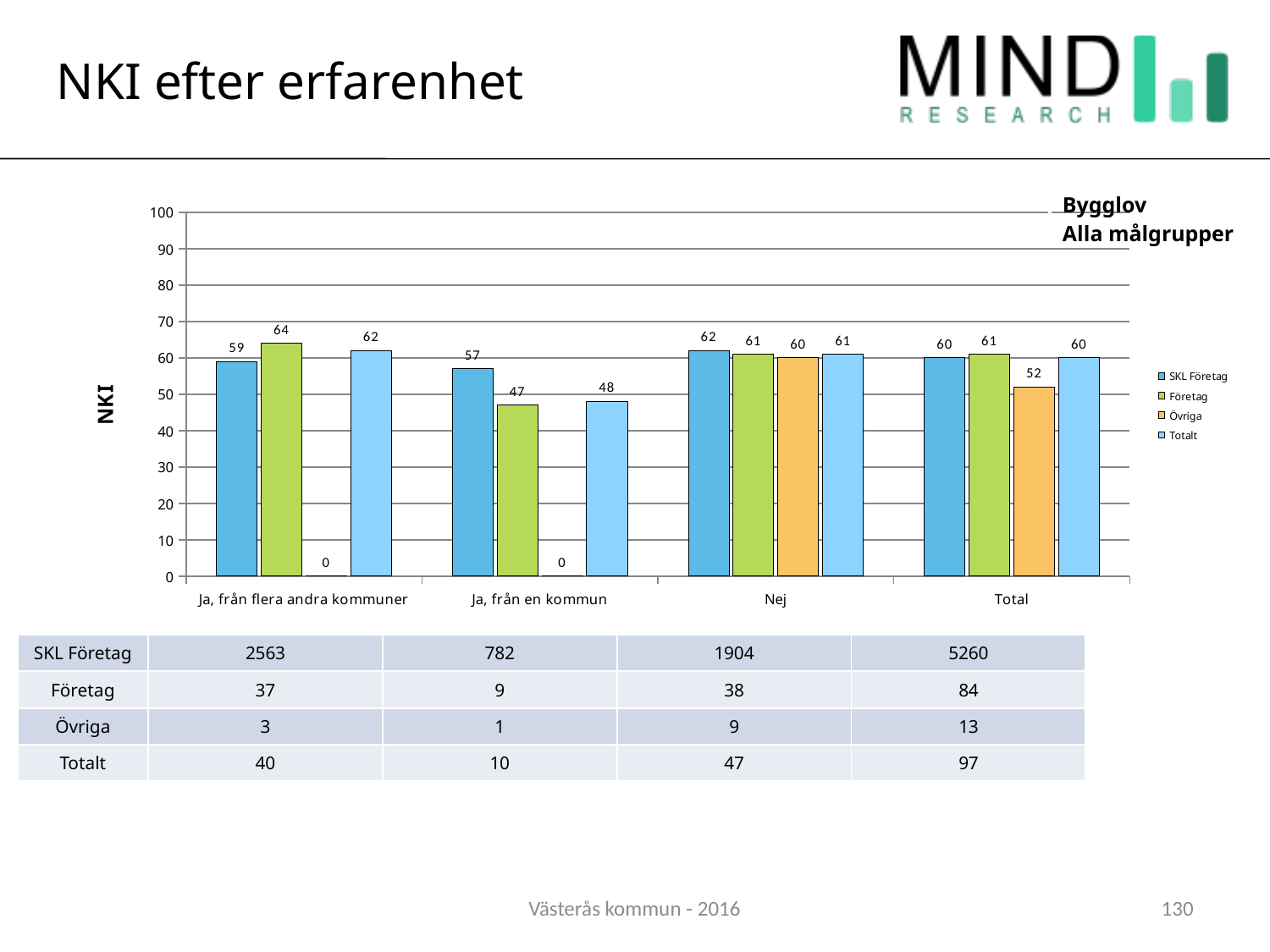
What is the NKI value for Övriga in the 'Total' category? 52 How many series does the legend list? 4 What is the label on the y axis of the chart? NKI What is the NKI value for Totalt in the 'Nej' category? 61 How many categories are shown on the x axis? 4 What is the NKI value for SKL Företag in the 'Ja, från en kommun' category? 57 Which series has the highest value in the 'Ja, från flera andra kommuner' category? Företag Which is larger: the Totalt value for 'Ja, från flera andra kommuner' or the Totalt value for 'Ja, från en kommun'? Ja, från flera andra kommuner What is the difference between the Företag values for 'Ja, från flera andra kommuner' and 'Ja, från en kommun'? 17 What kind of chart is shown on the slide? Bar chart What is the NKI value for Företag in the 'Ja, från flera andra kommuner' category? 64 Which category has the lowest Företag value? Ja, från en kommun